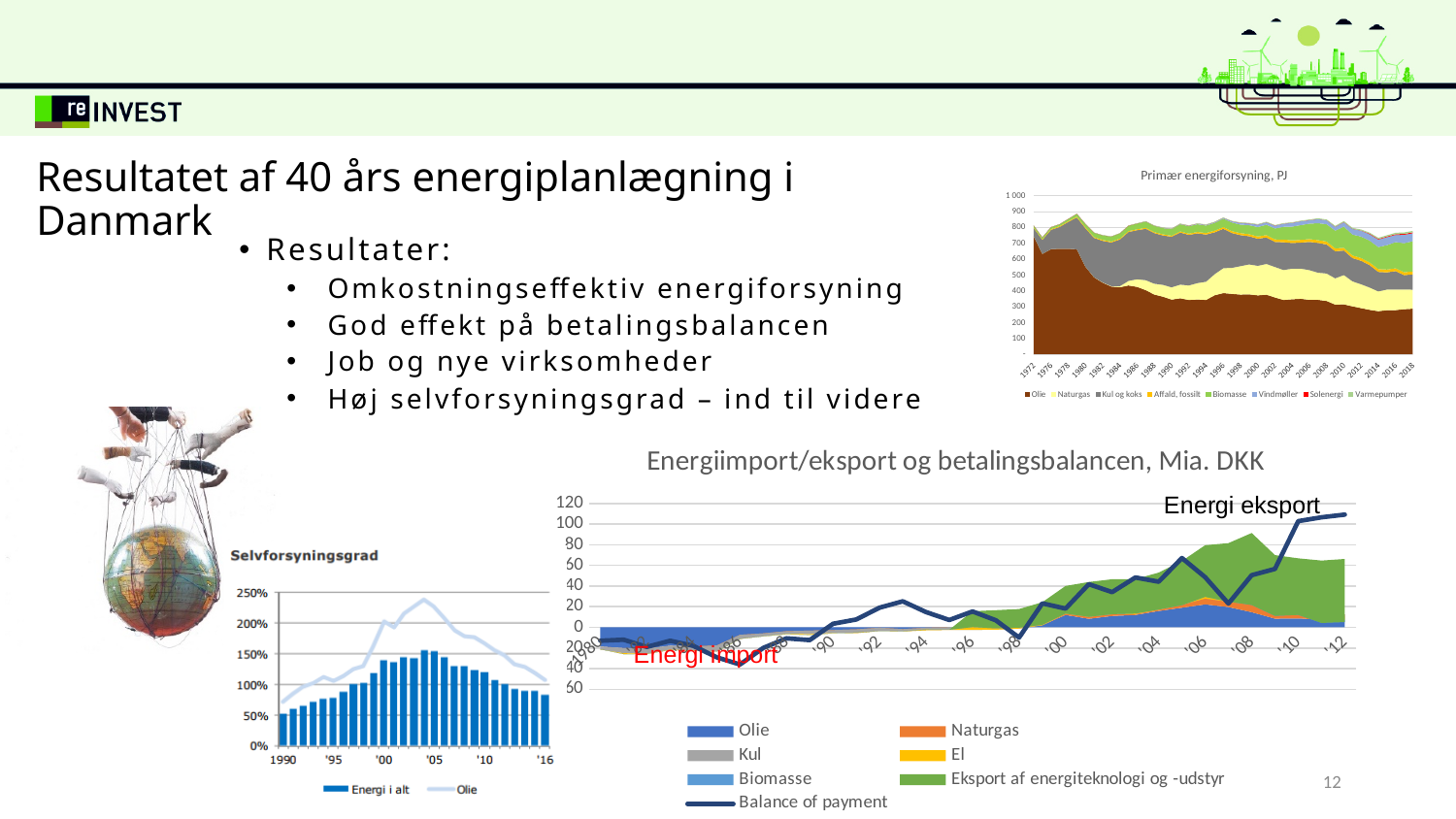
How many series does the legend of the 'Primær energiforsyning, PJ' chart list? 8 What is the title of the chart at the top right of the slide? Primær energiforsyning, PJ In the 'Energiimport/eksport og betalingsbalancen, Mia. DKK' chart, is the 'Balance of payment' value for '12 greater or less than 100? greater In the 'Selvforsyningsgrad' chart, do the 'Energi i alt' bars rise or fall from 2005 to 2016? fall In the 'Selvforsyningsgrad' chart, do the 'Energi i alt' bars rise or fall from 1990 to 2005? rise How many series does the legend of the 'Energiimport/eksport og betalingsbalancen, Mia. DKK' chart list? 7 In the 'Energiimport/eksport og betalingsbalancen, Mia. DKK' chart, which series is shown as a dark blue line? Balance of payment In the 'Selvforsyningsgrad' chart, is the 'Olie' line around 2005 greater or less than 200%? greater In the 'Energiimport/eksport og betalingsbalancen, Mia. DKK' chart, is the 'Balance of payment' value for '84 greater or less than 0? less What kind of chart is the 'Selvforsyningsgrad' chart at the bottom left of the slide? combination bar and line chart How many series does the legend of the 'Selvforsyningsgrad' chart list? 2